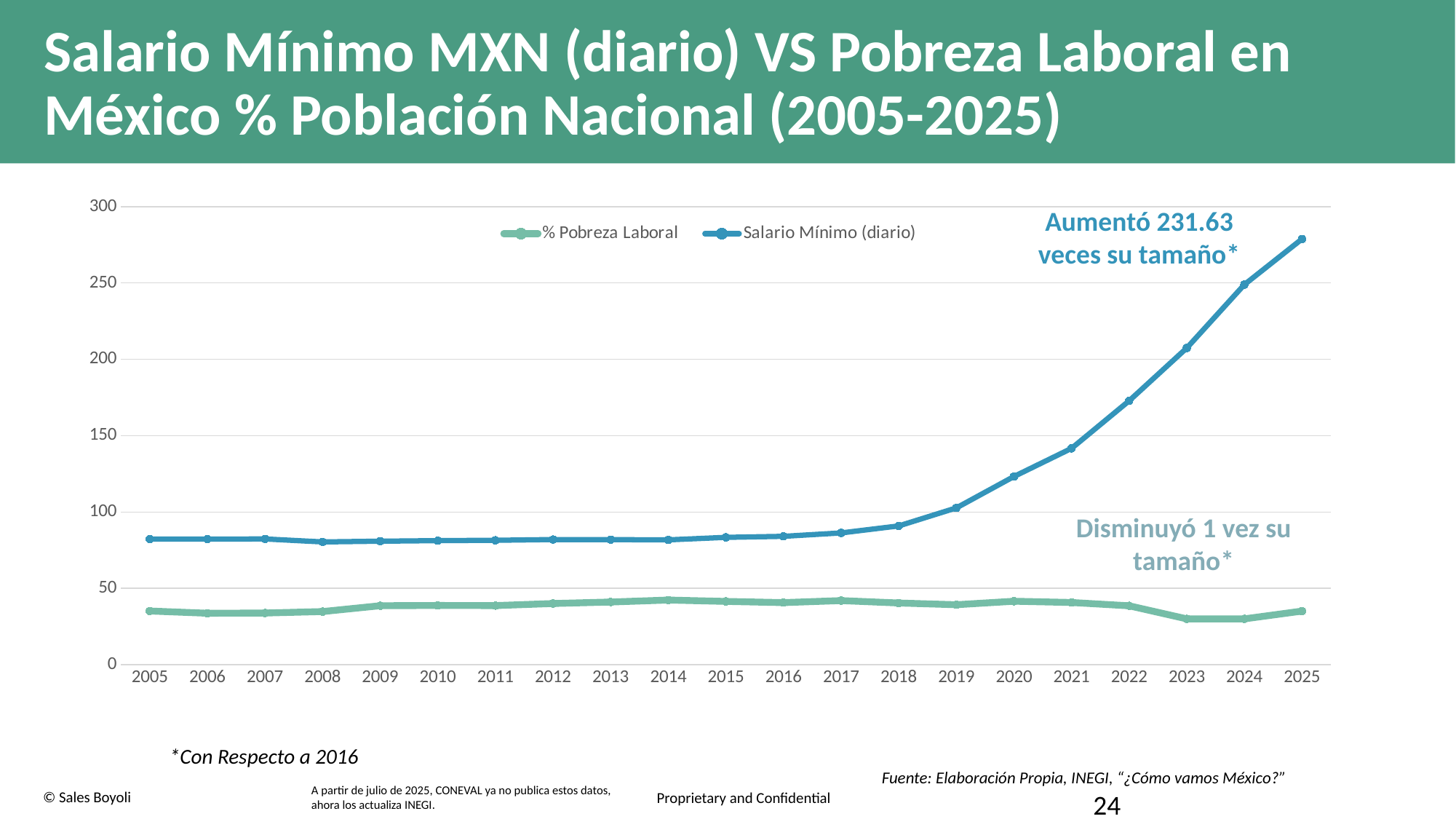
How many years are plotted along the x axis? 21 What kind of chart is shown on the slide? Line chart According to the annotation on the chart, by how many times did the Salario Mínimo increase with respect to 2016? 231.63 veces Is the value for Salario Mínimo (diario) in 2005 greater or less than 100? less Is the value for Salario Mínimo (diario) in 2025 greater or less than 250? greater Does the Salario Mínimo (diario) line rise or fall from 2018 to 2025? Rise Which series has the higher value in 2025, % Pobreza Laboral or Salario Mínimo (diario)? Salario Mínimo (diario) Is the value for Salario Mínimo (diario) in 2020 greater or less than 150? less Which year has the highest value for Salario Mínimo (diario)? 2025 What colour is the Salario Mínimo (diario) line? Blue How many series does the legend list? 2